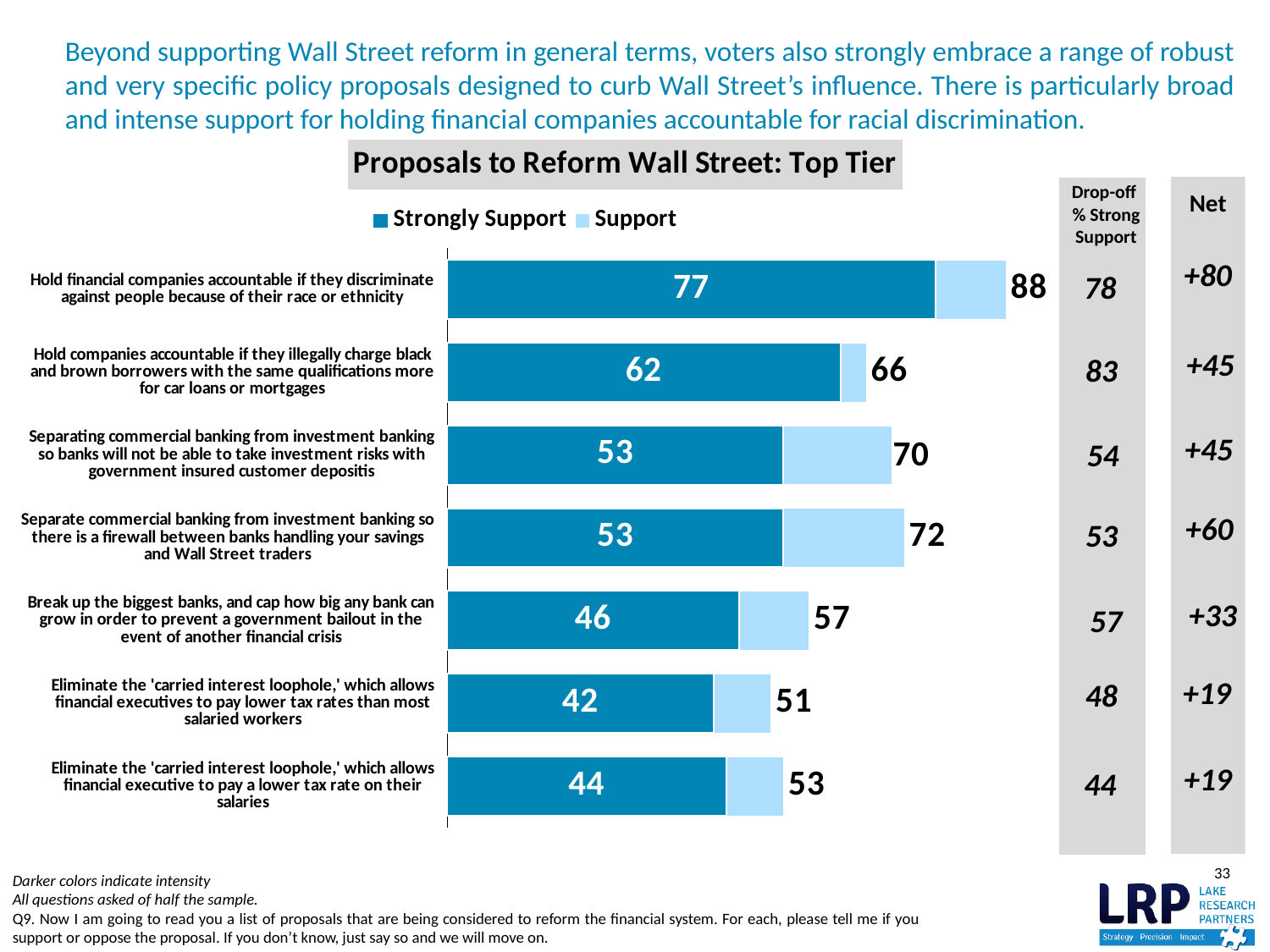
What are the two series named in the chart's legend? Strongly Support and Support What is the difference in Strongly Support between "Hold financial companies accountable if they discriminate against people because of their race or ethnicity" (77) and "Hold companies accountable if they illegally charge black and brown borrowers with the same qualifications more for car loans or mortgages" (62)? 15 What is the total support shown at the end of the bar for "Break up the biggest banks, and cap how big any bank can grow in order to prevent a government bailout in the event of another financial crisis"? 57 What is the Strongly Support value for "Hold companies accountable if they illegally charge black and brown borrowers with the same qualifications more for car loans or mortgages"? 62 Which has a larger Strongly Support value: "Separating commercial banking from investment banking so banks will not be able to take investment risks with government insured customer depositis" or "Break up the biggest banks, and cap how big any bank can grow in order to prevent a government bailout in the event of another financial crisis"? Separating commercial banking from investment banking so banks will not be able to take investment risks with government insured customer depositis How many proposals (categories) are plotted in the chart? 7 How many series does the legend of the chart list? 2 What kind of chart is shown under the title "Proposals to Reform Wall Street: Top Tier"? Bar chart Which proposal has the lowest Strongly Support value? Eliminate the 'carried interest loophole,' which allows financial executives to pay lower tax rates than most salaried workers Which proposal has the highest Strongly Support value? Hold financial companies accountable if they discriminate against people because of their race or ethnicity What is the Strongly Support value for "Hold financial companies accountable if they discriminate against people because of their race or ethnicity"? 77 What is the total support (Strongly Support plus Support) shown for "Hold financial companies accountable if they discriminate against people because of their race or ethnicity"? 88